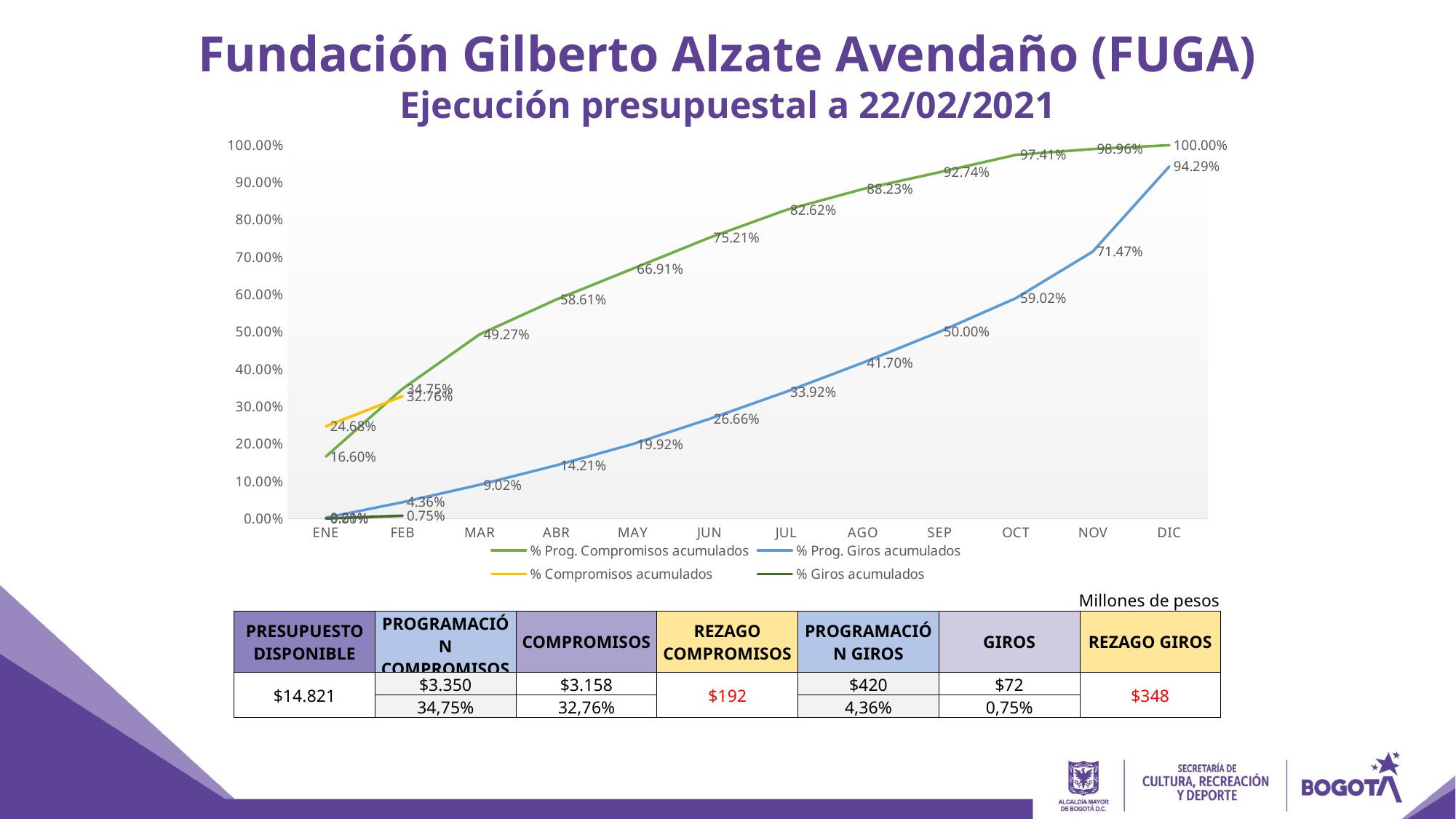
What is the difference between % Prog. Compromisos acumulados and % Prog. Giros acumulados in SEP? 42.74% Which is larger in FEB: % Prog. Compromisos acumulados or % Compromisos acumulados? % Prog. Compromisos acumulados What is the value of % Prog. Compromisos acumulados in MAR? 49.27% What colour is the line for % Prog. Giros acumulados? blue In which month does % Prog. Compromisos acumulados reach its highest value? DIC How many months are shown on the x axis of the chart? 12 What is the value of % Compromisos acumulados in ENE? 24.68% Does % Prog. Giros acumulados rise or fall from ENE to DIC? rise What is the value of % Prog. Giros acumulados in DIC? 94.29% What is the value of % Giros acumulados in FEB? 0.75% How many series does the chart legend list? 4 What type of chart is shown on the slide? line chart